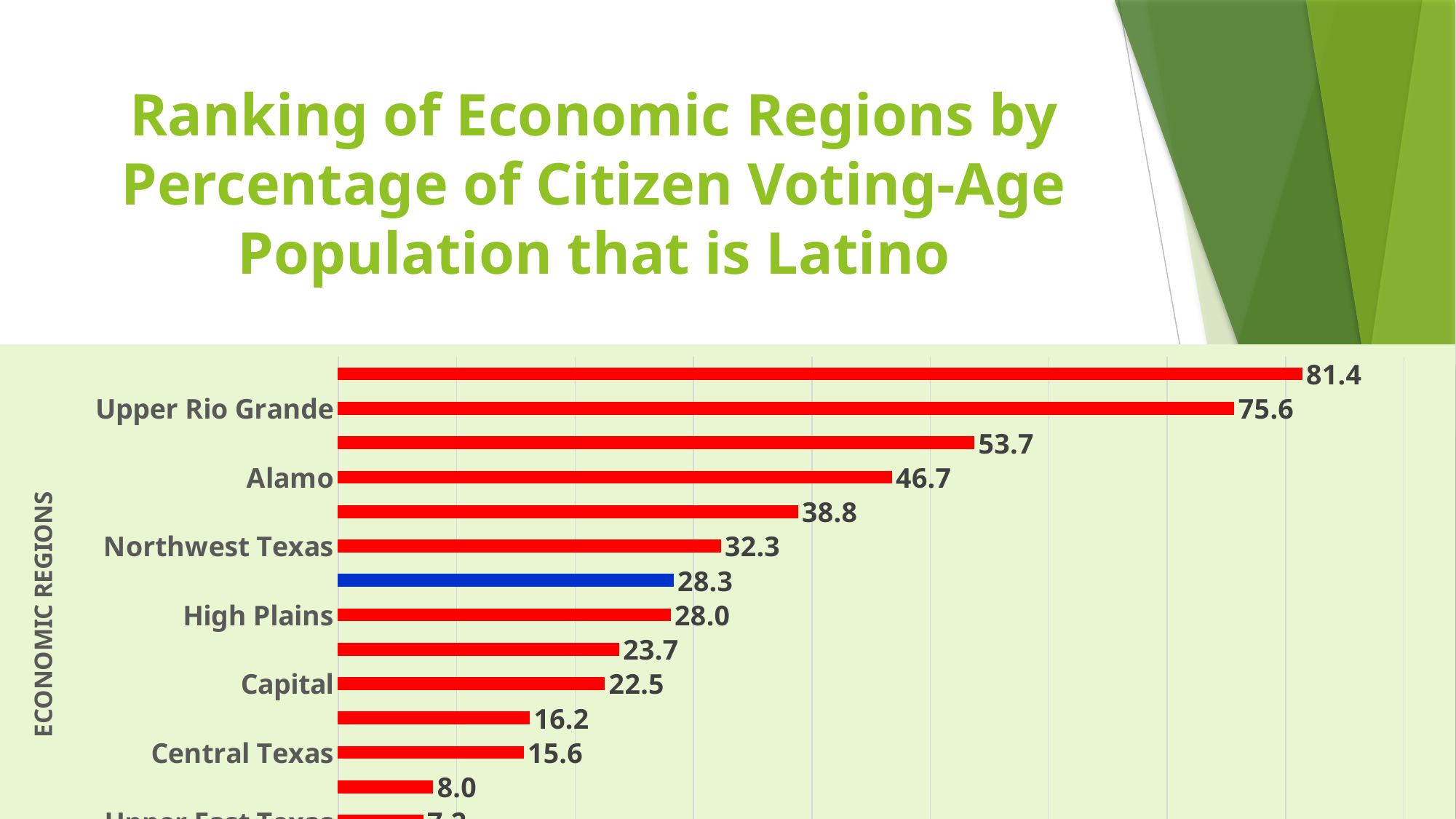
What kind of chart is shown on the slide? Bar chart What is the difference between the values for Upper Rio Grande and Alamo? 28.9 Of the regions whose names are shown on the axis, which has the highest value? Upper Rio Grande What value is labelled on the blue bar? 28.3 What is the value for High Plains? 28.0 What is the value for Northwest Texas? 32.3 What is the value for Central Texas? 15.6 Which is larger, the value for Northwest Texas or the value for High Plains? Northwest Texas What is the value for Alamo? 46.7 What is the value for Upper Rio Grande? 75.6 What is the value for Capital? 22.5 What is the difference between the values for Capital and Central Texas? 6.9